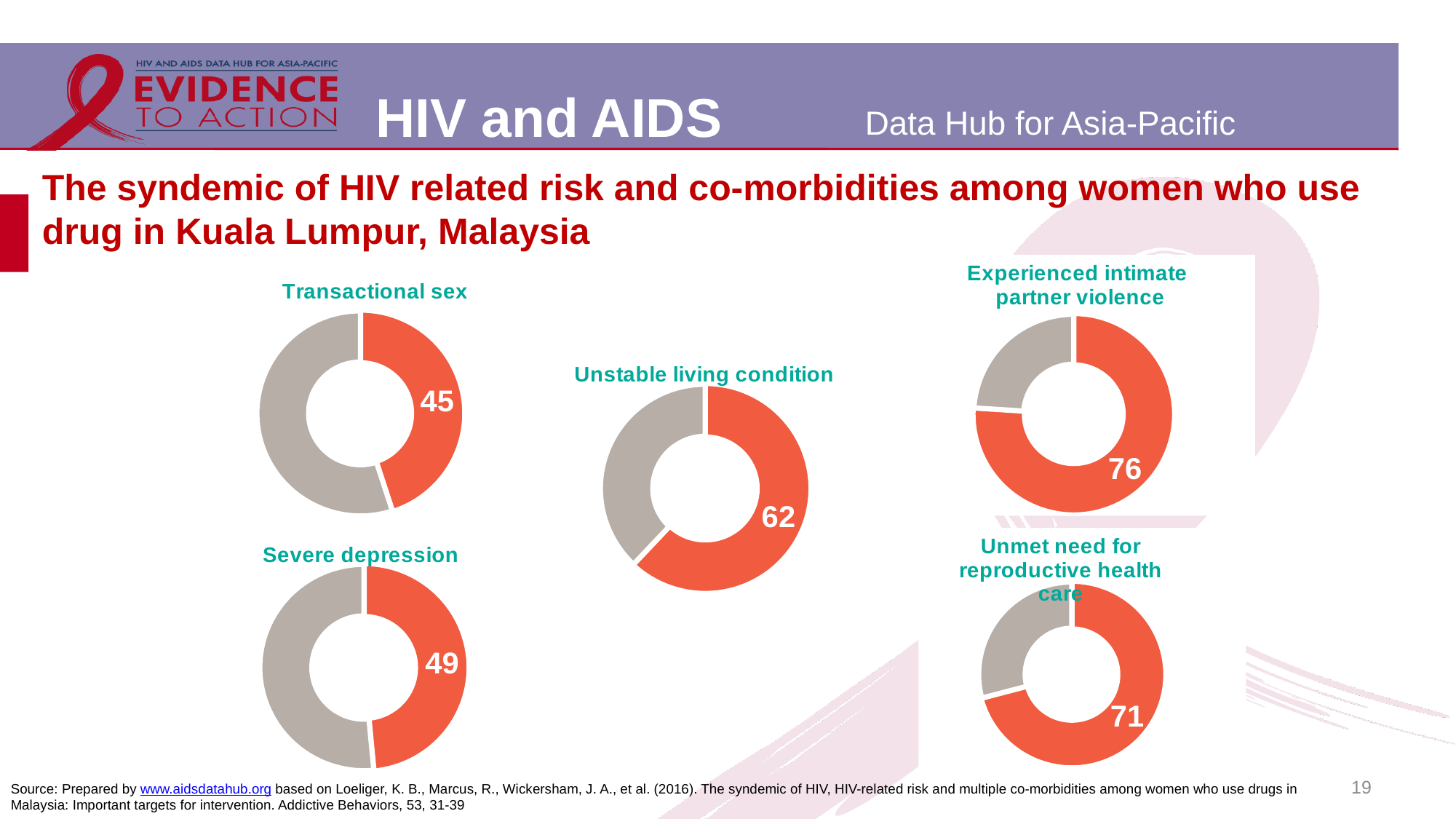
What is the difference between the value in the 'Experienced intimate partner violence' chart and the value in the 'Transactional sex' chart? 31 In the 'Unmet need for reproductive health care' donut chart, what value is printed on the orange segment? 71 Which is larger: the value in the 'Unstable living condition' chart or the value in the 'Severe depression' chart? Unstable living condition In the 'Experienced intimate partner violence' donut chart, what value is printed on the orange segment? 76 What type of chart is used for 'Severe depression'? Donut chart What colour is the segment that carries the printed value in each donut chart? Orange Across the five donut charts on the slide, which indicator has the highest printed value? Experienced intimate partner violence In the 'Transactional sex' donut chart, what value is printed on the orange segment? 45 In the 'Severe depression' donut chart, what value is printed on the orange segment? 49 In the 'Unstable living condition' donut chart, what value is printed on the orange segment? 62 Across the five donut charts on the slide, which indicator has the lowest printed value? Transactional sex How many donut charts are shown on the slide? 5